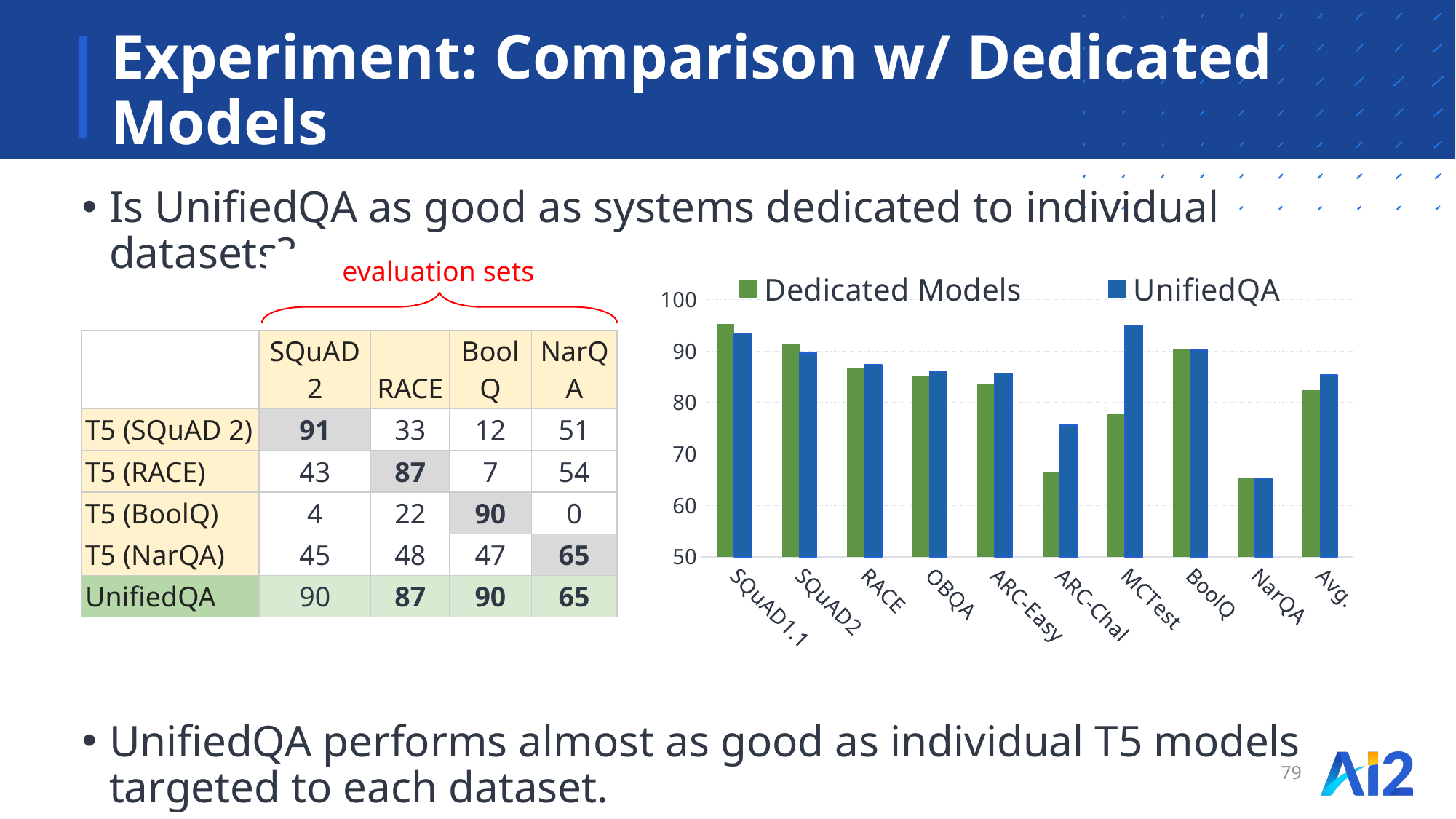
For SQuAD1.1, which series has the larger value, Dedicated Models or UnifiedQA? Dedicated Models Is the UnifiedQA value for NarQA greater or less than 70? less What kind of chart is shown on the slide? bar chart Is the Dedicated Models value for ARC-Chal greater or less than 70? less What colour are the UnifiedQA bars in the chart? blue Is the Dedicated Models value for MCTest greater or less than 80? less How many categories are shown along the x axis of the chart? 10 Which category has the lowest UnifiedQA value? NarQA For ARC-Chal, which series has the larger value, Dedicated Models or UnifiedQA? UnifiedQA Which two series are listed in the chart's legend? Dedicated Models and UnifiedQA How many series does the chart's legend list? 2